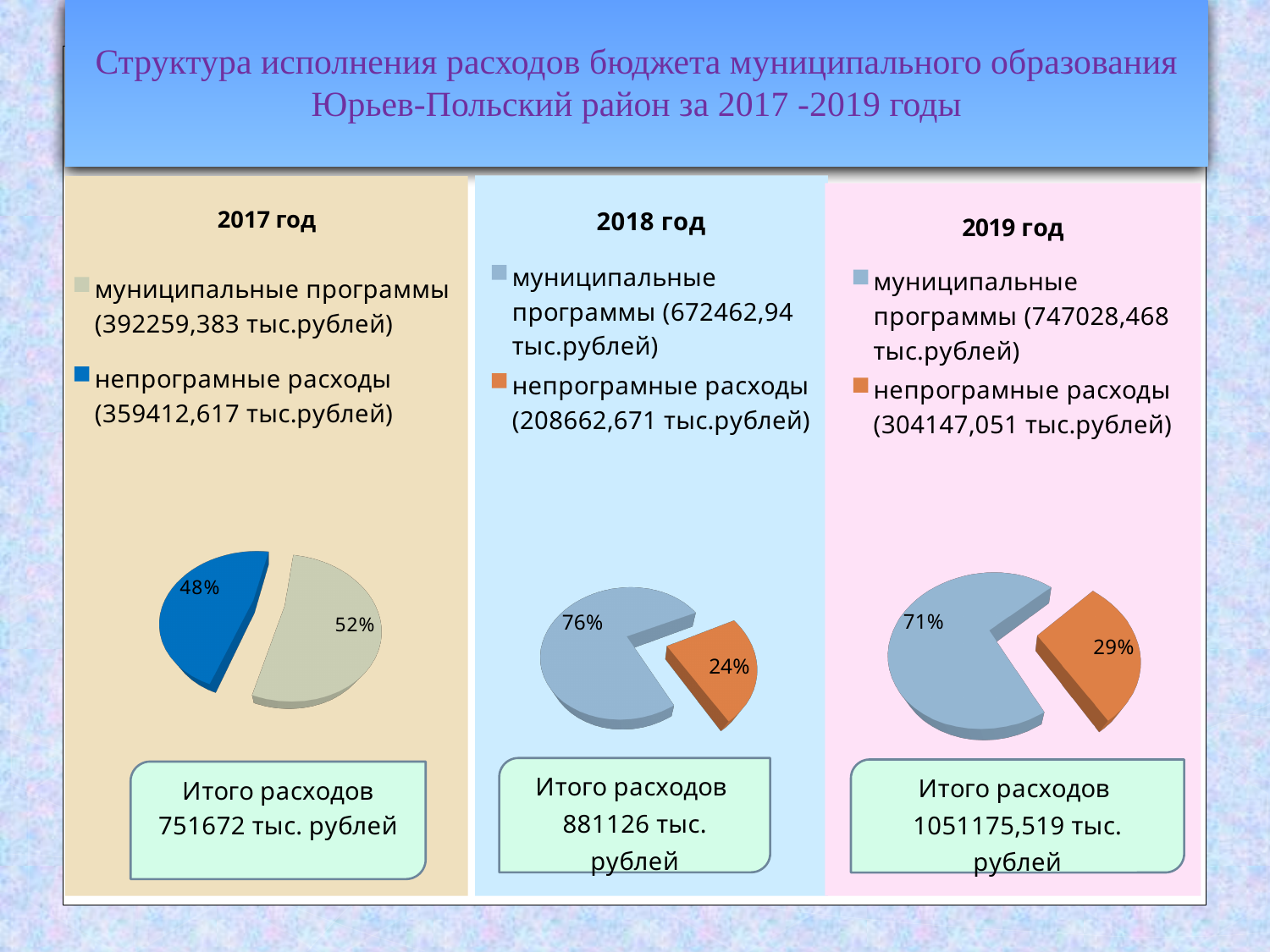
На диаграмме «2019 год» какую долю составляют муниципальные программы? 71% На диаграмме «2017 год» какую долю составляют непрограмные расходы? 48% На диаграмме «2017 год» какую долю составляют муниципальные программы? 52% На диаграмме «2018 год» какая категория занимает наибольшую долю? муниципальные программы Сколько категорий показано на диаграмме «2019 год»? 2 На диаграмме «2018 год» на сколько процентных пунктов доля муниципальных программ больше доли непрограмных расходов? 52 Каким цветом на диаграмме «2019 год» показаны непрограмные расходы? оранжевым На диаграмме «2017 год» что больше: доля муниципальных программ или доля непрограмных расходов? муниципальные программы Сколько круговых диаграмм показано на слайде? 3 Какого типа диаграммы показаны на слайде? круговые диаграммы На диаграмме «2019 год» какая категория занимает наименьшую долю? непрограмные расходы